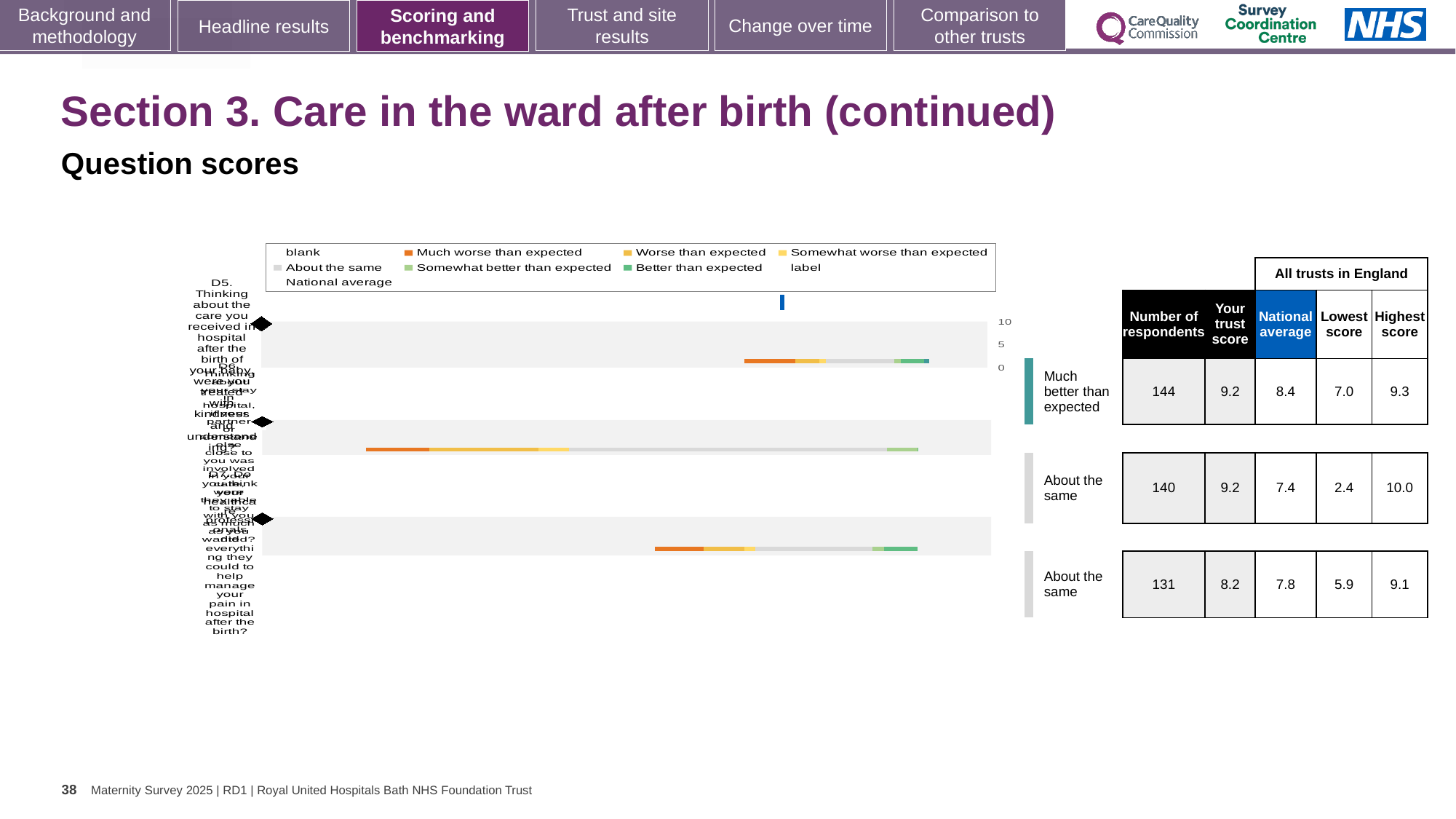
In the table beside the chart, what is the lowest score for the row with 140 respondents? 2.4 How many bars are plotted in the chart? 3 In the table beside the chart, what is the national average for the row with 131 respondents? 7.8 In the table beside the chart, what is the national average for the row with 144 respondents? 8.4 What colour does the chart legend use for 'Much worse than expected'? orange In the table beside the chart, what is the 'Your trust score' for the row with 144 respondents? 9.2 What is the highest tick value shown on the chart's axis? 10 In the table beside the chart, what is the highest score for the row with 131 respondents? 9.1 What kind of chart is shown on the slide? bar chart In the table beside the chart, what is the difference between the trust score and the national average for the row with 131 respondents? 0.4 In the table beside the chart, which row has the largest number of respondents? 144 In the table beside the chart, which is larger for the row with 140 respondents: the trust score or the national average? trust score